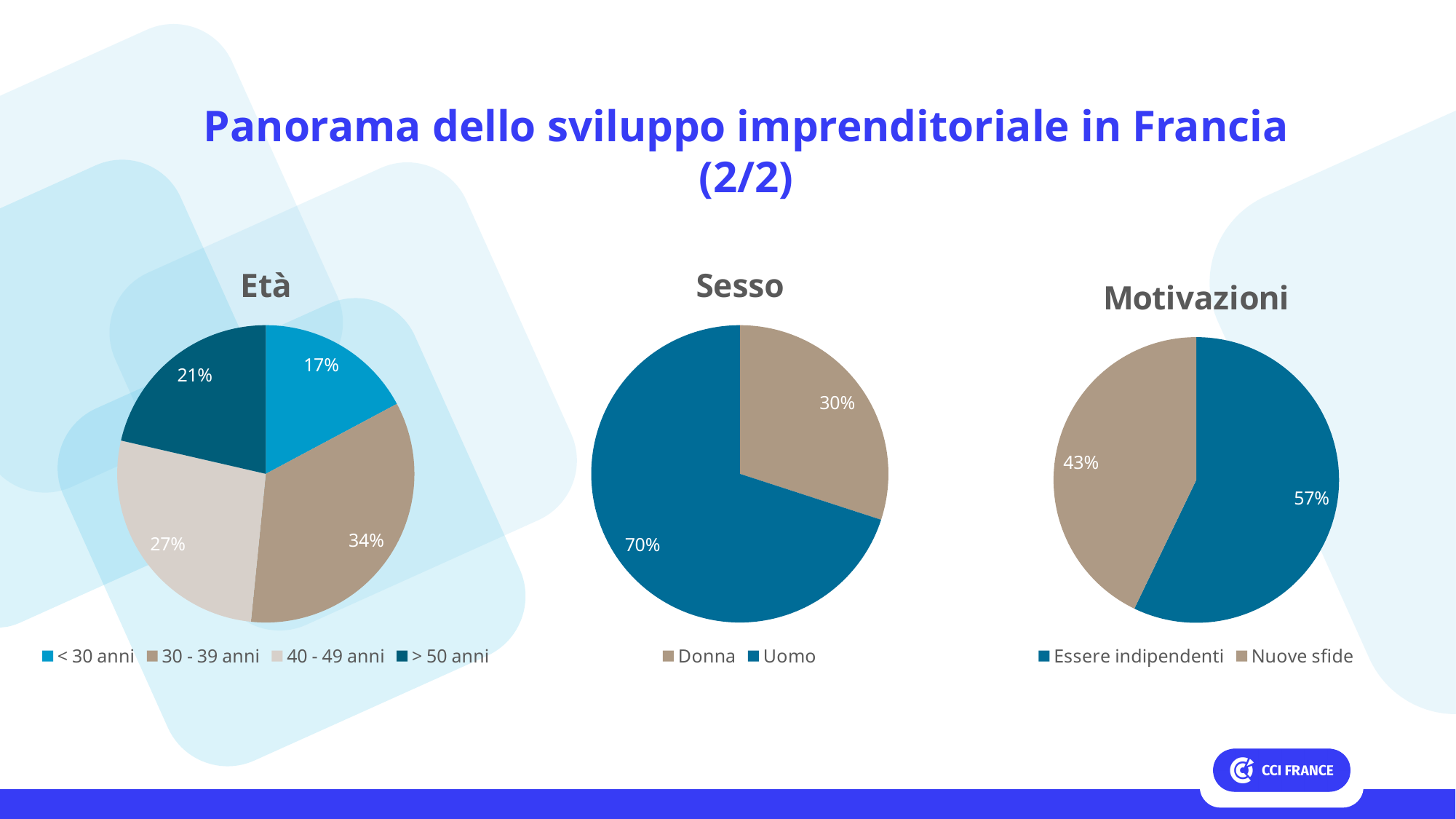
What kind of chart is the 'Sesso' chart? Pie chart How many entries does the legend of the 'Motivazioni' chart list? 2 In the 'Motivazioni' chart, what share is shown for 'Nuove sfide'? 43% In the 'Sesso' chart, which is larger, 'Donna' or 'Uomo'? Uomo How many categories does the 'Età' chart show? 4 In the 'Età' chart, which age group has the largest share? 30 - 39 anni In the 'Età' chart, what is the difference between the shares for '40 - 49 anni' and '> 50 anni'? 6% In the 'Motivazioni' chart, what is the difference between 'Essere indipendenti' and 'Nuove sfide'? 14% In the 'Età' chart, which age group has the smallest share? < 30 anni In the 'Età' chart, what share is shown for '< 30 anni'? 17% In the 'Età' chart, what share is shown for '30 - 39 anni'? 34% In the 'Sesso' chart, what share is shown for 'Uomo'? 70%